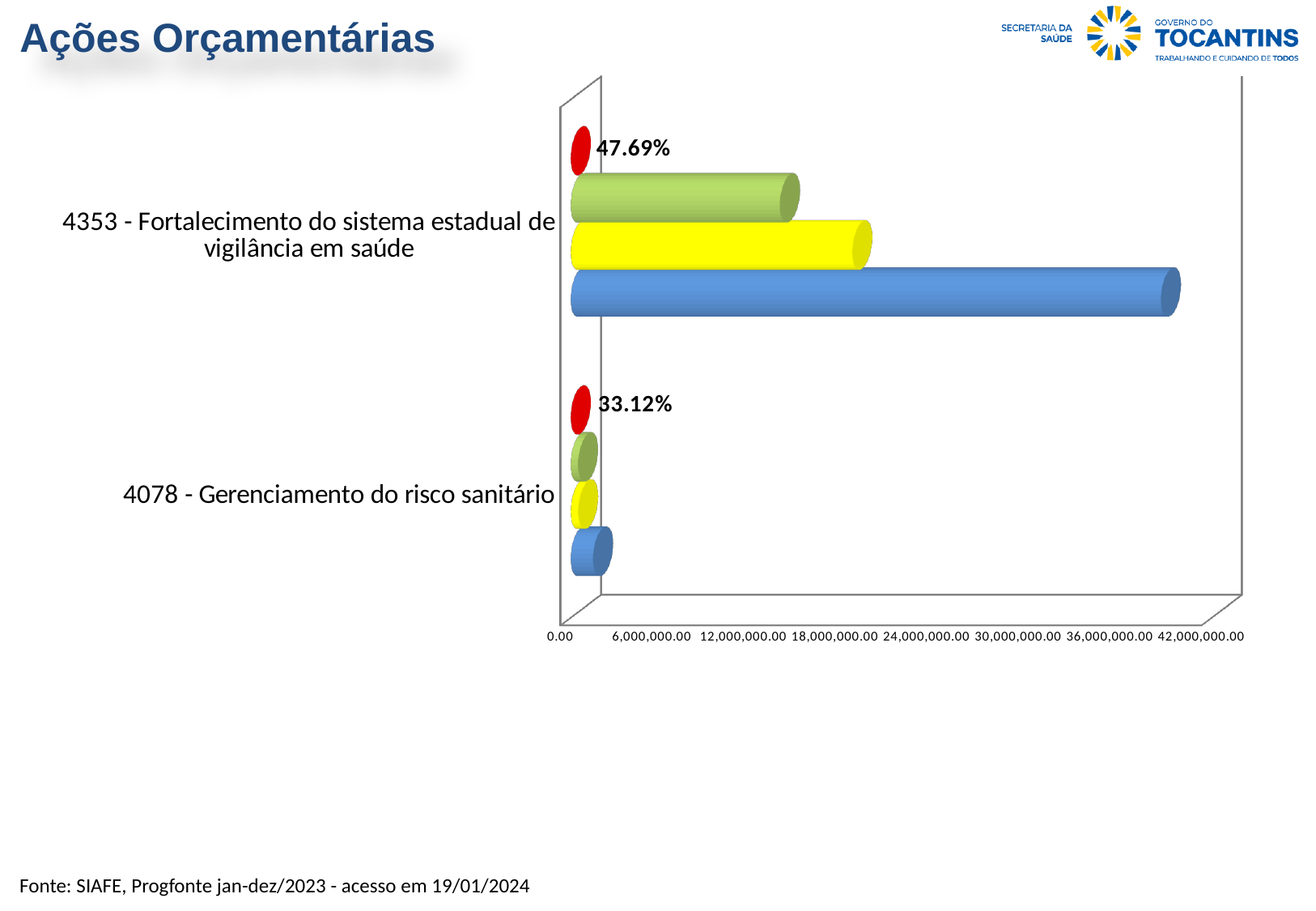
What is the title of the slide containing the chart? Ações Orçamentárias What is the difference between the percentage labels of the two categories? 14.57% What is the highest value shown on the horizontal axis? 42,000,000.00 Which category has the higher percentage label? 4353 - Fortalecimento do sistema estadual de vigilância em saúde How many categories (budget actions) are shown on the chart? 2 Which category has the longest blue bar? 4353 - Fortalecimento do sistema estadual de vigilância em saúde What percentage is labelled for '4353 - Fortalecimento do sistema estadual de vigilância em saúde'? 47.69% Is the value of the green bar for '4353 - Fortalecimento do sistema estadual de vigilância em saúde' greater or less than 12,000,000.00? greater Is the value of the blue bar for '4078 - Gerenciamento do risco sanitário' greater or less than 6,000,000.00? less Is the value of the blue bar for '4353 - Fortalecimento do sistema estadual de vigilância em saúde' greater or less than 36,000,000.00? greater What kind of chart is shown on the slide? bar chart What percentage is labelled for '4078 - Gerenciamento do risco sanitário'? 33.12%